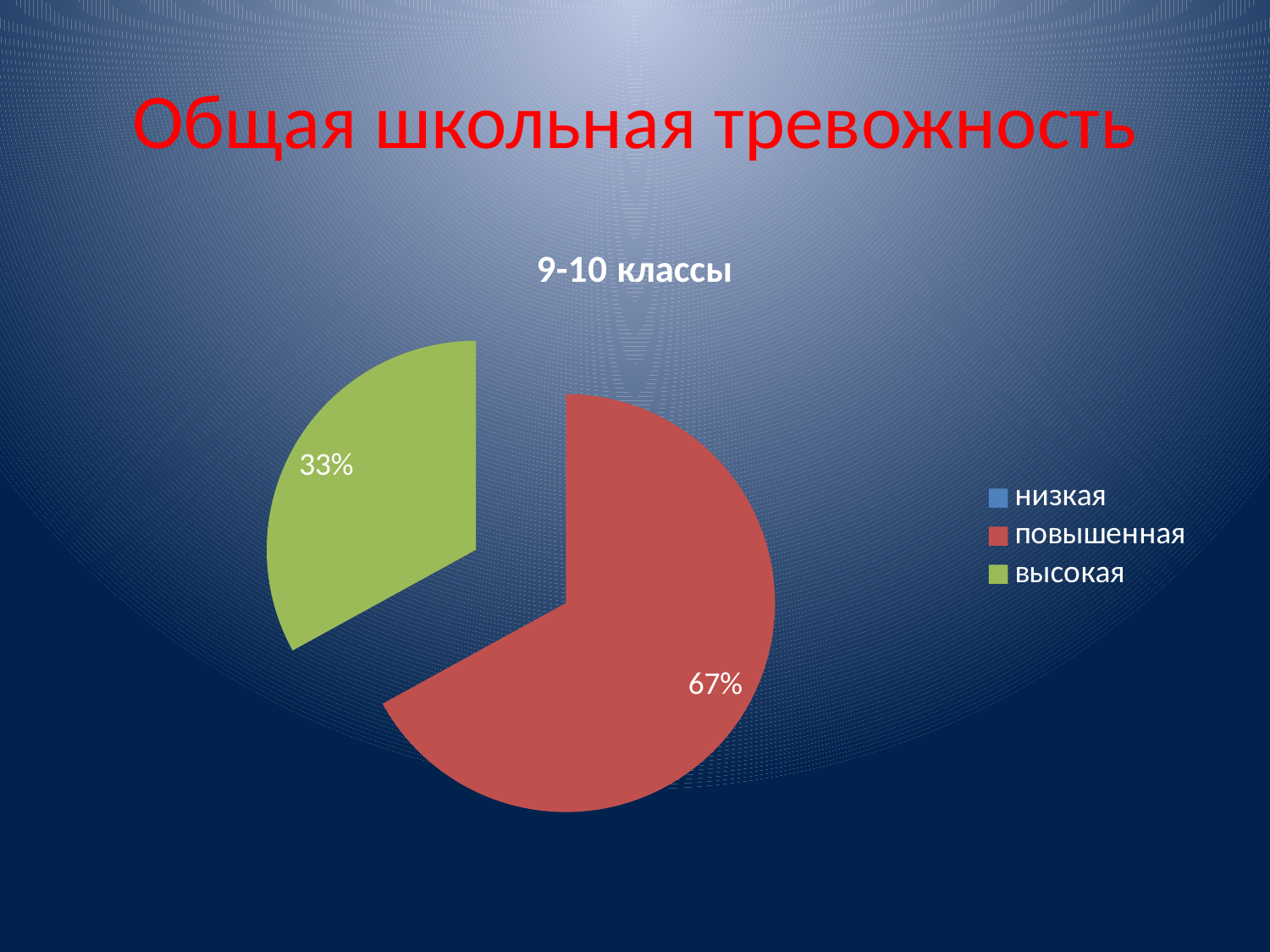
Which category has the largest slice of the pie? повышенная How many entries does the legend list? 3 Which is larger, the повышенная slice or the высокая slice? повышенная What colour is the повышенная slice? red What percentage does the высокая slice show? 33% What is the difference in percentage points between the повышенная slice and the высокая slice? 34% What is the title of the chart? 9-10 классы What kind of chart is shown on the slide? pie chart How many slices have a percentage label printed on the pie? 2 What percentage does the повышенная slice show? 67% What share of the pie does the высокая slice take? 33%